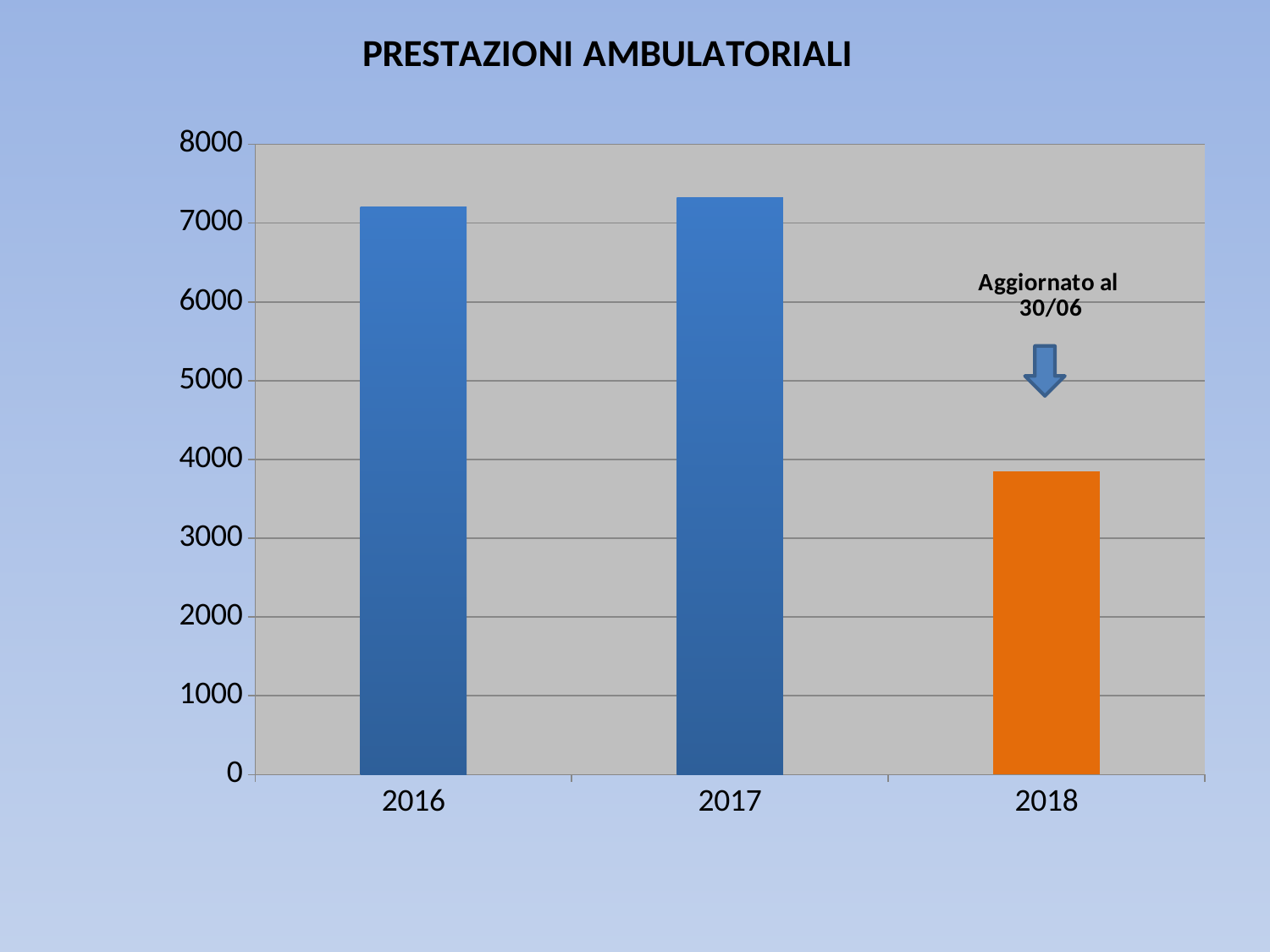
What is the title of the chart? PRESTAZIONI AMBULATORIALI Which year has the lowest value in the chart? 2018 How many years are shown on the x axis of the chart? 3 Which is larger, the value for 2017 or the value for 2018? 2017 Is the value for 2017 greater or less than 7000? greater Is the value for 2018 greater or less than 4000? less Which is larger, the value for 2016 or the value for 2018? 2016 What kind of chart is shown on the slide? bar chart Is the value for 2016 greater or less than 7000? greater What does the annotation above the 2018 bar say? Aggiornato al 30/06